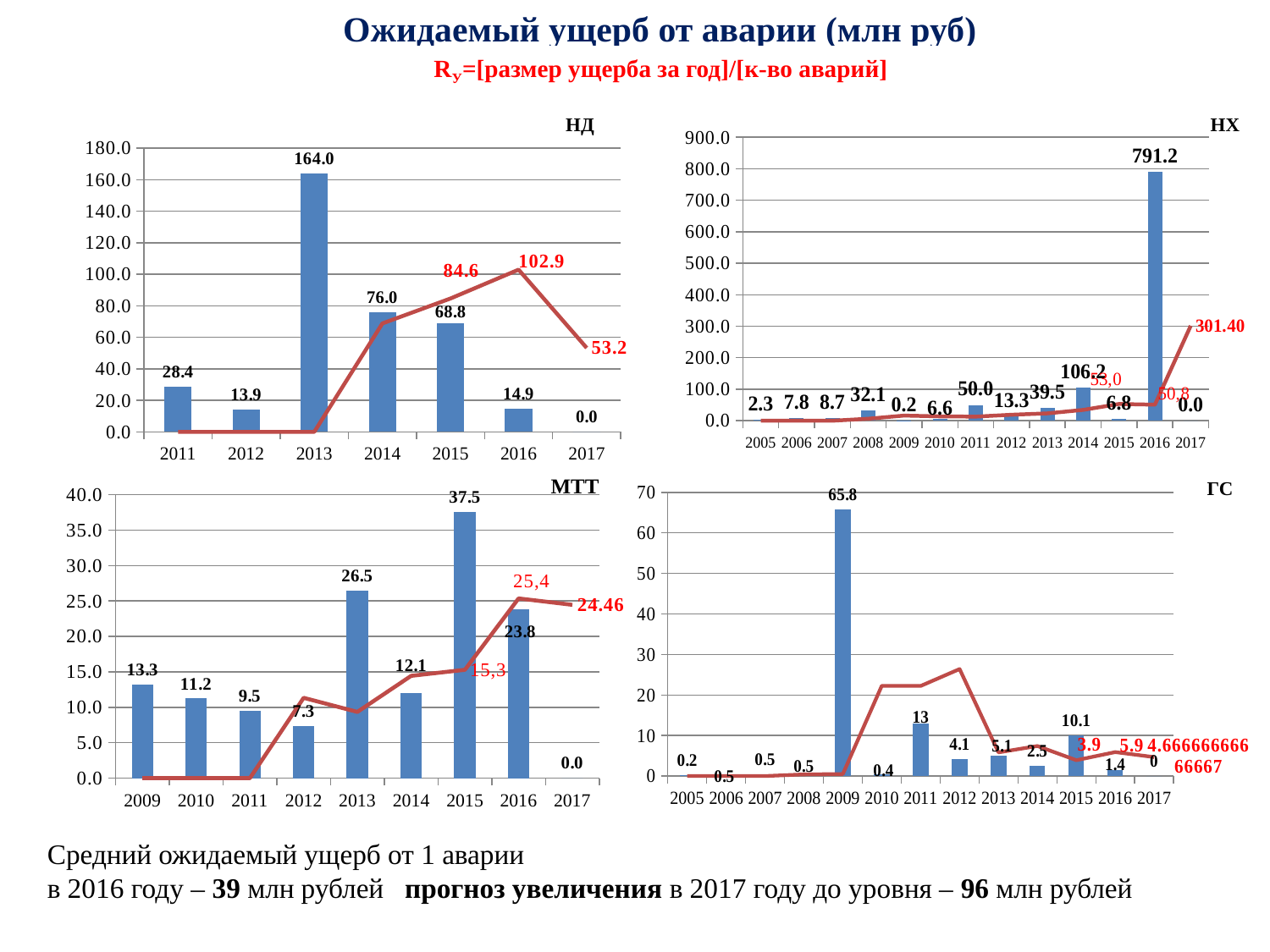
In the ГС chart (bottom right), is the bar value for 2011 greater or less than 10? greater In the НД chart (top left), what is the difference between the bar values for 2014 and 2015? 7.2 In the ГС chart (bottom right), what is the bar value for 2009? 65.8 In the НД chart (top left), what is the bar value for 2013? 164.0 In the МТТ chart (bottom left), which is larger, the bar for 2013 or the bar for 2016? 2013 In the НХ chart (top right), which year has the lowest bar value among 2005 to 2016? 2009 In the НД chart (top left), which year has the highest bar? 2013 In the МТТ chart (bottom left), how many years are shown on the x axis? 9 What type of chart is the НД chart (top left)? Bar chart with a line In the МТТ chart (bottom left), what is the bar value for 2015? 37.5 In the НХ chart (top right), what is the value of the red line at 2017? 301.40 In the НХ chart (top right), what is the bar value for 2016? 791.2